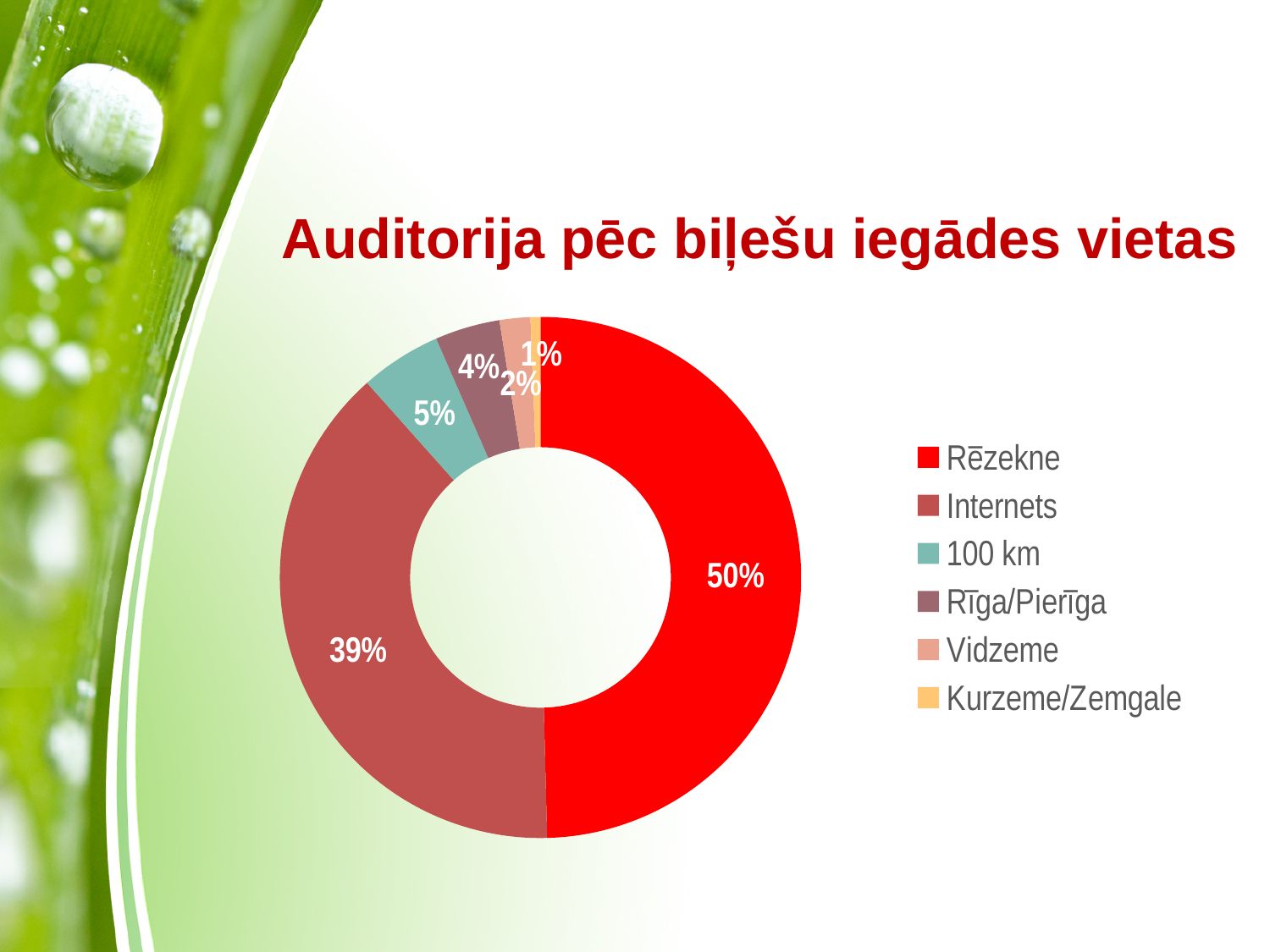
What is the value for Vidzeme? 2% What kind of chart is shown on the slide? Doughnut (pie) chart Which is larger, the share for 100 km or the share for Rīga/Pierīga? 100 km What is the difference in percentage points between Rēzekne and Internets? 11 Which category has the largest share of the chart? Rēzekne Which category has the smallest share of the chart? Kurzeme/Zemgale What is the value for the 100 km slice? 5% What percentage is shown for Internets? 39% What share of the audience bought tickets in Rēzekne? 50% What is the title of the chart? Auditorija pēc biļešu iegādes vietas How many categories does the chart show? 6 What percentage is shown for Rīga/Pierīga? 4%